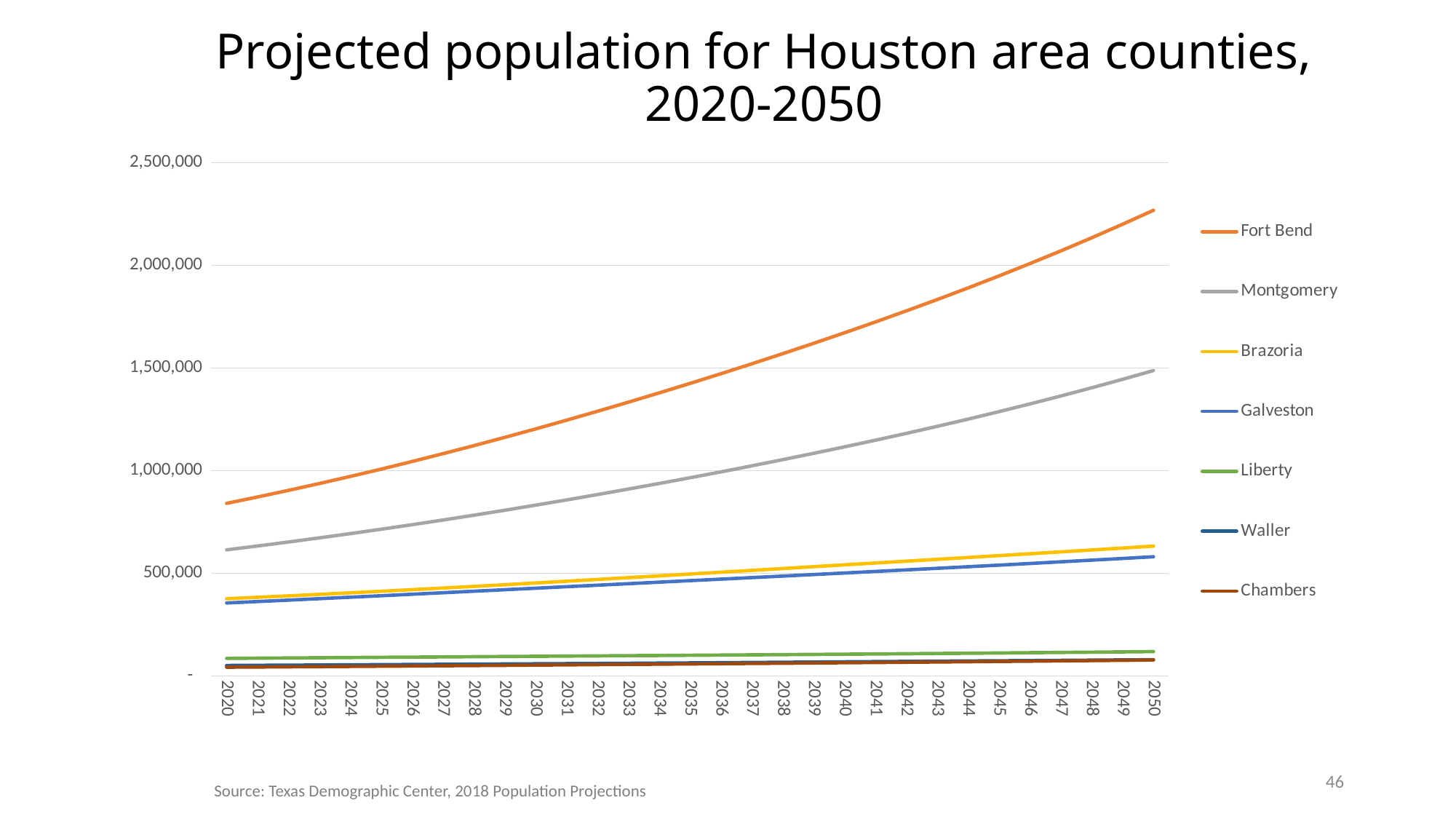
How many series does the legend list? 7 Which county has the highest projected population in 2050? Fort Bend What kind of chart is shown on the slide? line chart Does the projected population for Fort Bend rise or fall from 2020 to 2050? rise Is the projected population for Brazoria in 2050 greater or less than 500,000? greater How many years are shown on the x axis? 31 Is the projected population for Fort Bend in 2050 greater or less than 2,000,000? greater Is the projected population for Fort Bend in 2020 greater or less than 1,000,000? less What is the source cited at the bottom of the slide? Texas Demographic Center, 2018 Population Projections Which county has the larger projected population in 2050, Montgomery or Galveston? Montgomery